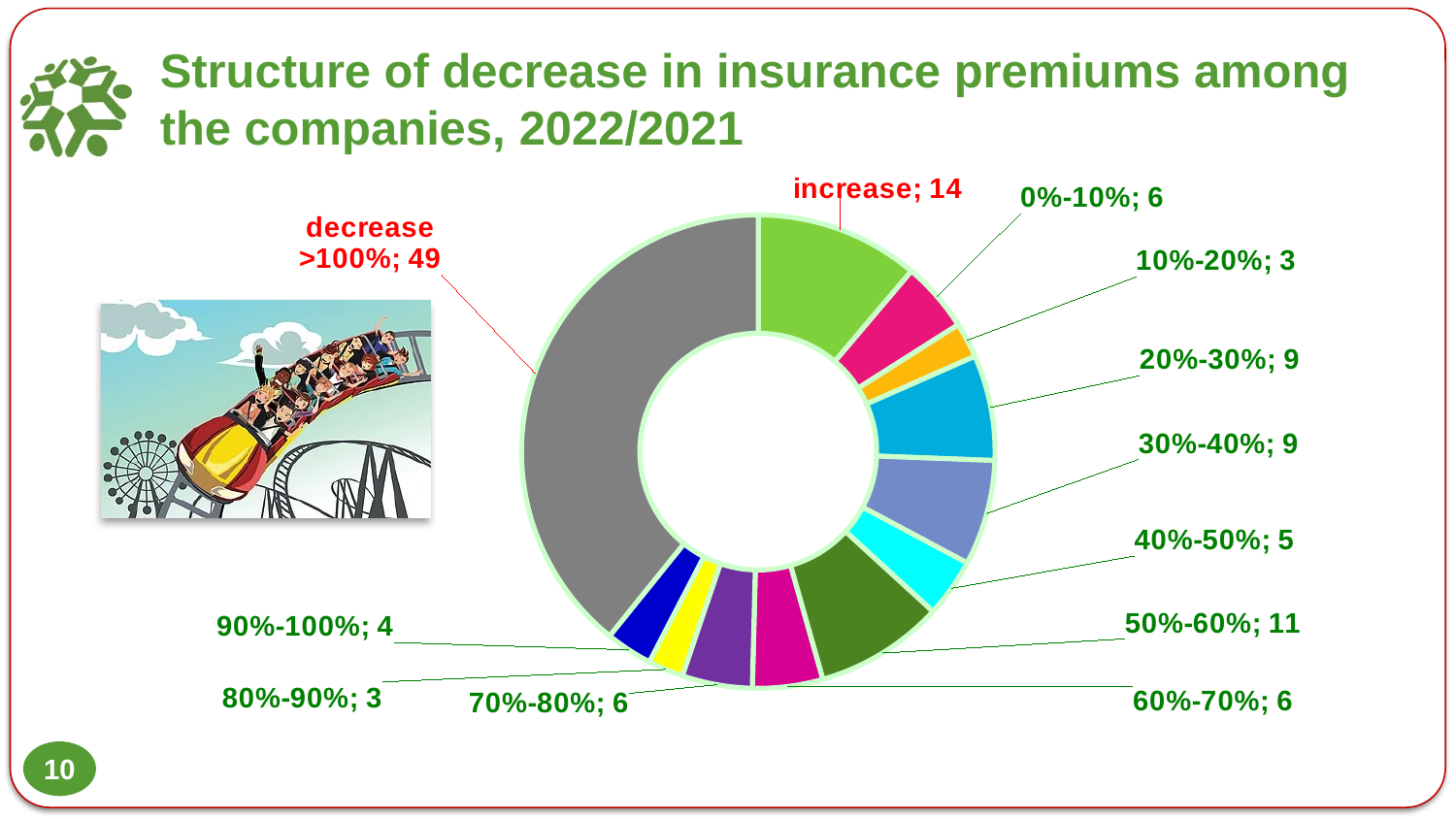
What is the value shown for the "90%-100%" category? 4 What is the difference between the values for "decrease >100%" and "increase"? 35 What is the value shown for the "50%-60%" category? 11 What is the value shown for the "decrease >100%" category? 49 Which is larger, the value for "0%-10%" or the value for "10%-20%"? 0%-10% What is the title of the chart on the slide? Structure of decrease in insurance premiums among the companies, 2022/2021 What kind of chart is shown on the slide? doughnut chart How many companies are in the "increase" category? 14 What is the difference between the values for "50%-60%" and "40%-50%"? 6 How many categories are shown in the chart? 12 Which category has the largest value in the chart? decrease >100% Which is larger, the value for "20%-30%" or the value for "40%-50%"? 20%-30%